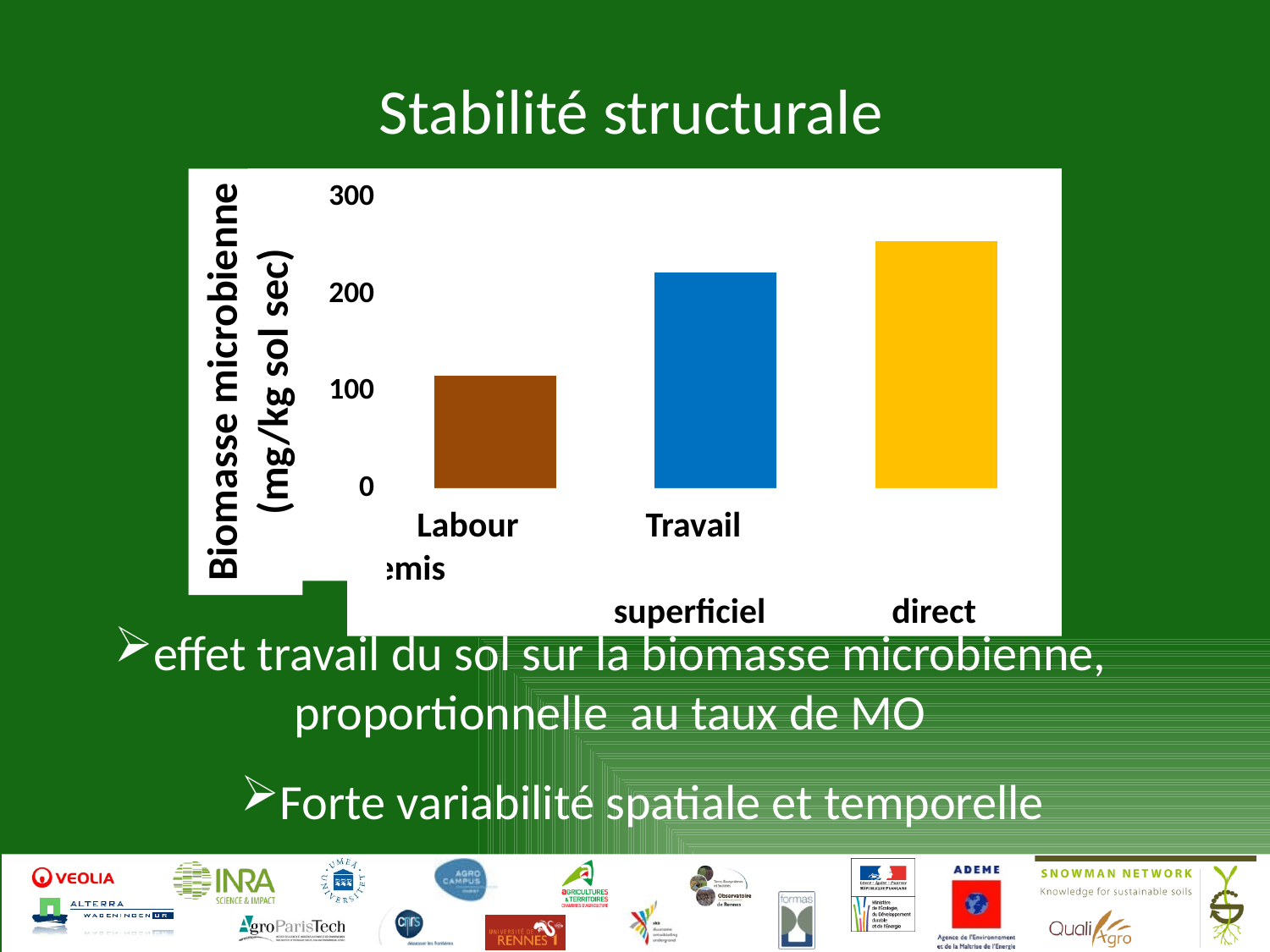
What kind of chart is shown on the slide? bar chart What colour is the bar for Travail superficiel? blue How many bars (categories) does the chart show? 3 What is the label of the vertical axis? Biomasse microbienne (mg/kg sol sec) Do the values rise or fall from left to right across the categories? rise Is the value for Travail superficiel greater or less than 200? greater Which category has the highest microbial biomass? Semis direct Which is larger, the value for Travail superficiel or the value for Labour? Travail superficiel Is the value for Labour greater or less than 100? greater Which category has the lowest microbial biomass? Labour Is the value for the rightmost bar (direct) greater or less than 300? less